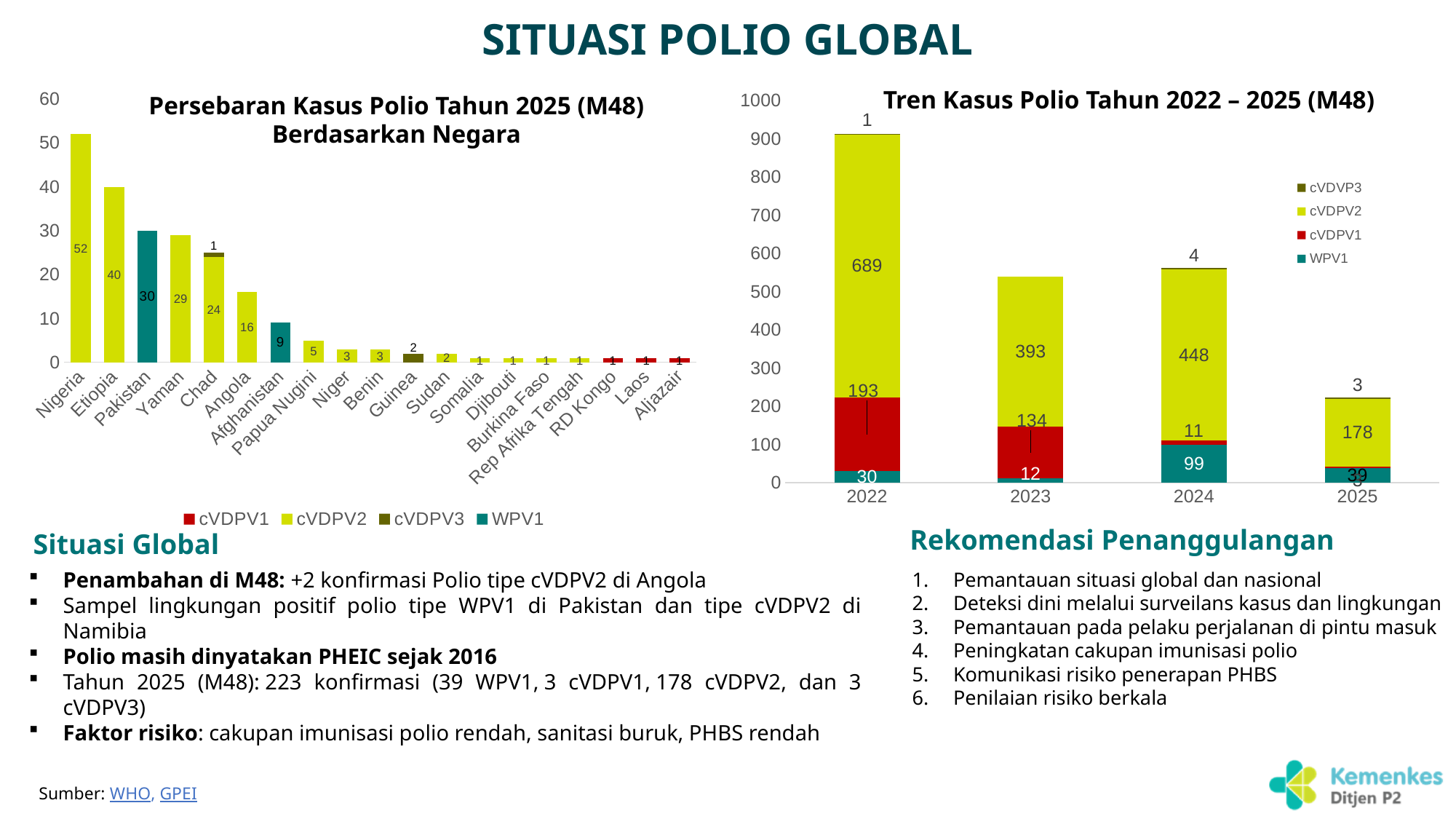
In the chart 'Tren Kasus Polio Tahun 2022 – 2025 (M48)', which year has the tallest stacked bar? 2022 In the chart 'Tren Kasus Polio Tahun 2022 – 2025 (M48)', what is the WPV1 value for 2024? 99 How many series does the legend of the chart 'Persebaran Kasus Polio Tahun 2025 (M48) Berdasarkan Negara' list? 4 In the chart 'Tren Kasus Polio Tahun 2022 – 2025 (M48)', what is the total of the stacked bar for 2025? 223 What kind of chart is 'Tren Kasus Polio Tahun 2022 – 2025 (M48)'? Stacked bar chart How many countries are shown in the chart 'Persebaran Kasus Polio Tahun 2025 (M48) Berdasarkan Negara'? 19 In the chart 'Persebaran Kasus Polio Tahun 2025 (M48) Berdasarkan Negara', what is the difference between the values for Nigeria and Etiopia? 12 In the chart 'Persebaran Kasus Polio Tahun 2025 (M48) Berdasarkan Negara', what is the value for Nigeria? 52 In the chart 'Tren Kasus Polio Tahun 2022 – 2025 (M48)', what is the cVDPV2 value for 2022? 689 In the chart 'Tren Kasus Polio Tahun 2022 – 2025 (M48)', which year has the larger WPV1 value, 2024 or 2025? 2024 In the chart 'Persebaran Kasus Polio Tahun 2025 (M48) Berdasarkan Negara', what is the value for Pakistan? 30 In the chart 'Persebaran Kasus Polio Tahun 2025 (M48) Berdasarkan Negara', which country has the highest number of cases? Nigeria